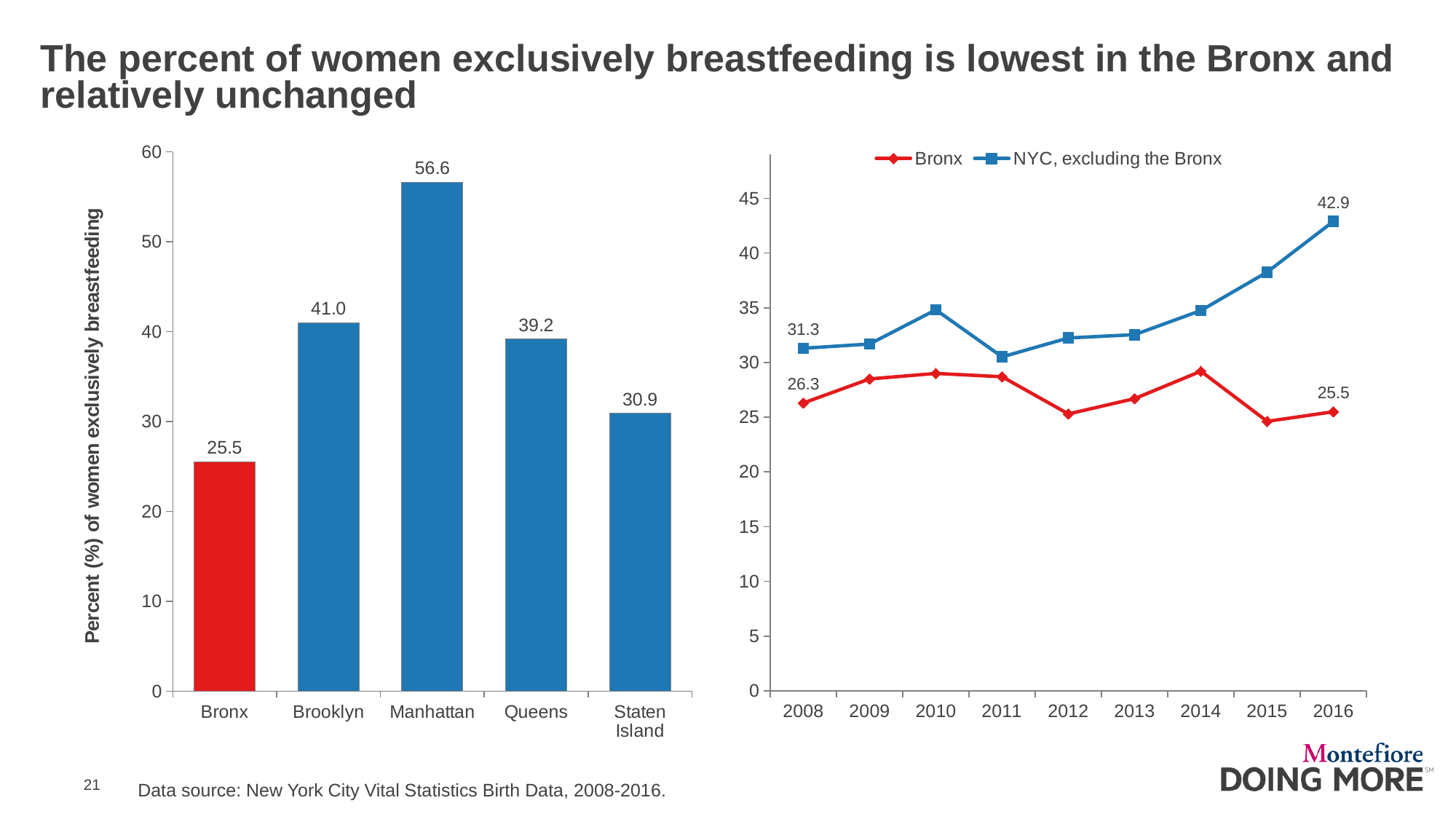
What type of chart is shown on the left side of the slide? Bar chart In the bar chart on the left, which borough has the lowest percent of women exclusively breastfeeding? Bronx In the bar chart on the left, how many boroughs are shown? 5 In the line chart on the right, what is the difference between the 2016 values for NYC, excluding the Bronx and the Bronx? 17.4 In the line chart on the right, what is the value for NYC, excluding the Bronx in 2016? 42.9 In the line chart on the right, how many series does the legend list? 2 In the bar chart on the left, which is larger, the value for Staten Island or the value for Queens? Queens In the bar chart on the left, what is the percent of women exclusively breastfeeding in Manhattan? 56.6 In the bar chart on the left, which borough has the highest percent of women exclusively breastfeeding? Manhattan In the line chart on the right, what is the value for the Bronx in 2008? 26.3 In the line chart on the right, is the value for NYC, excluding the Bronx in 2015 greater or less than 35? greater In the bar chart on the left, what is the difference between the values for Brooklyn and Queens? 1.8